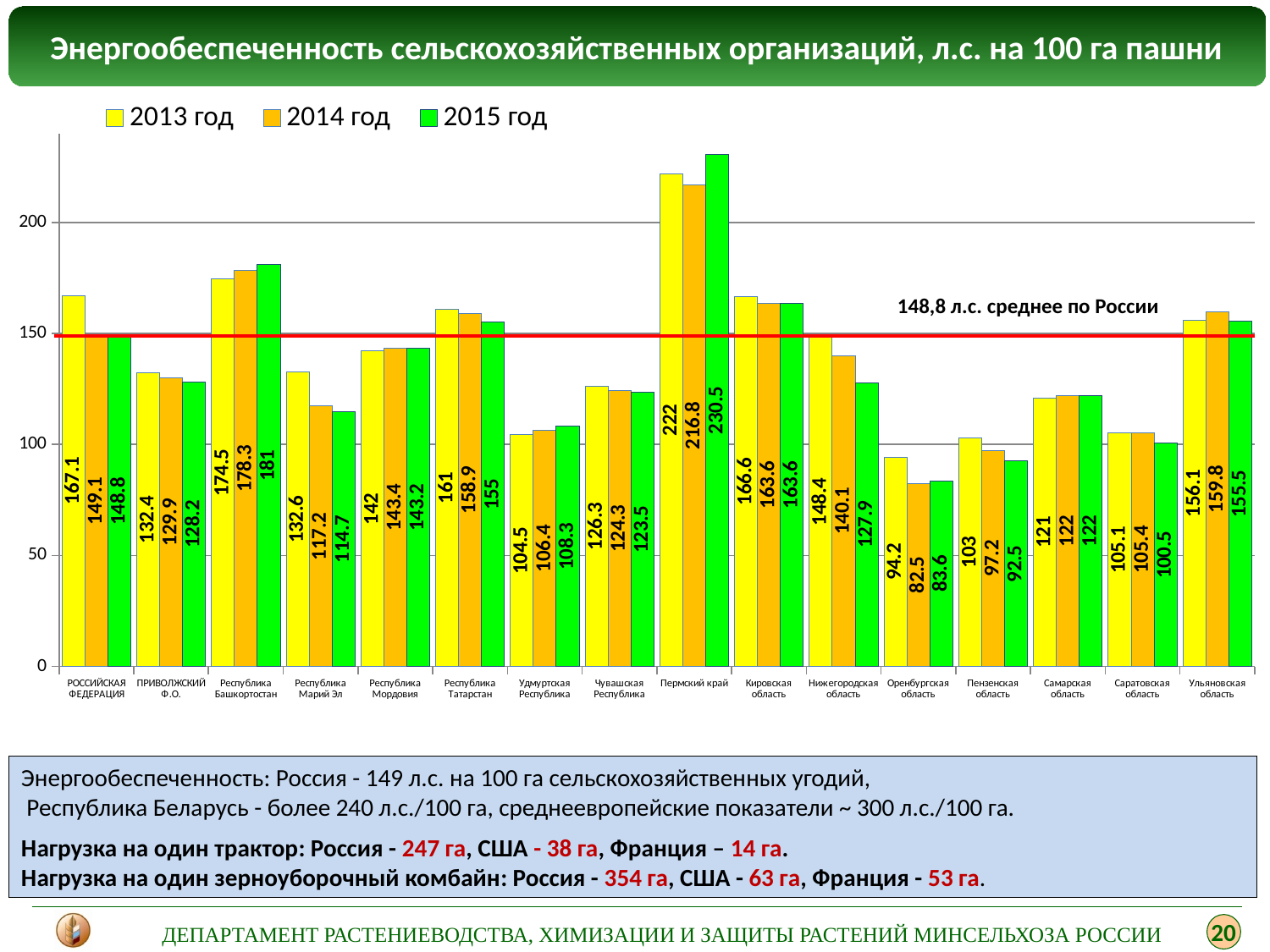
How many series does the legend list? 3 What is the difference between the 2013 год and 2015 год values for Нижегородская область? 20.5 What value does the red horizontal line on the chart mark as the average for Russia? 148,8 л.с. What is the value for Республика Башкортостан in 2013 год? 174.5 Which is larger for Ульяновская область: the 2014 год value or the 2015 год value? 2014 год What is the value for Оренбургская область in 2014 год? 82.5 Is the value for Республика Татарстан in 2013 год greater or less than 150? greater How many categories are shown on the x axis? 16 What kind of chart is shown on the slide? bar chart Which category has the highest value in 2015 год? Пермский край What is the value for Пермский край in 2015 год? 230.5 Which category has the lowest value in 2014 год? Оренбургская область